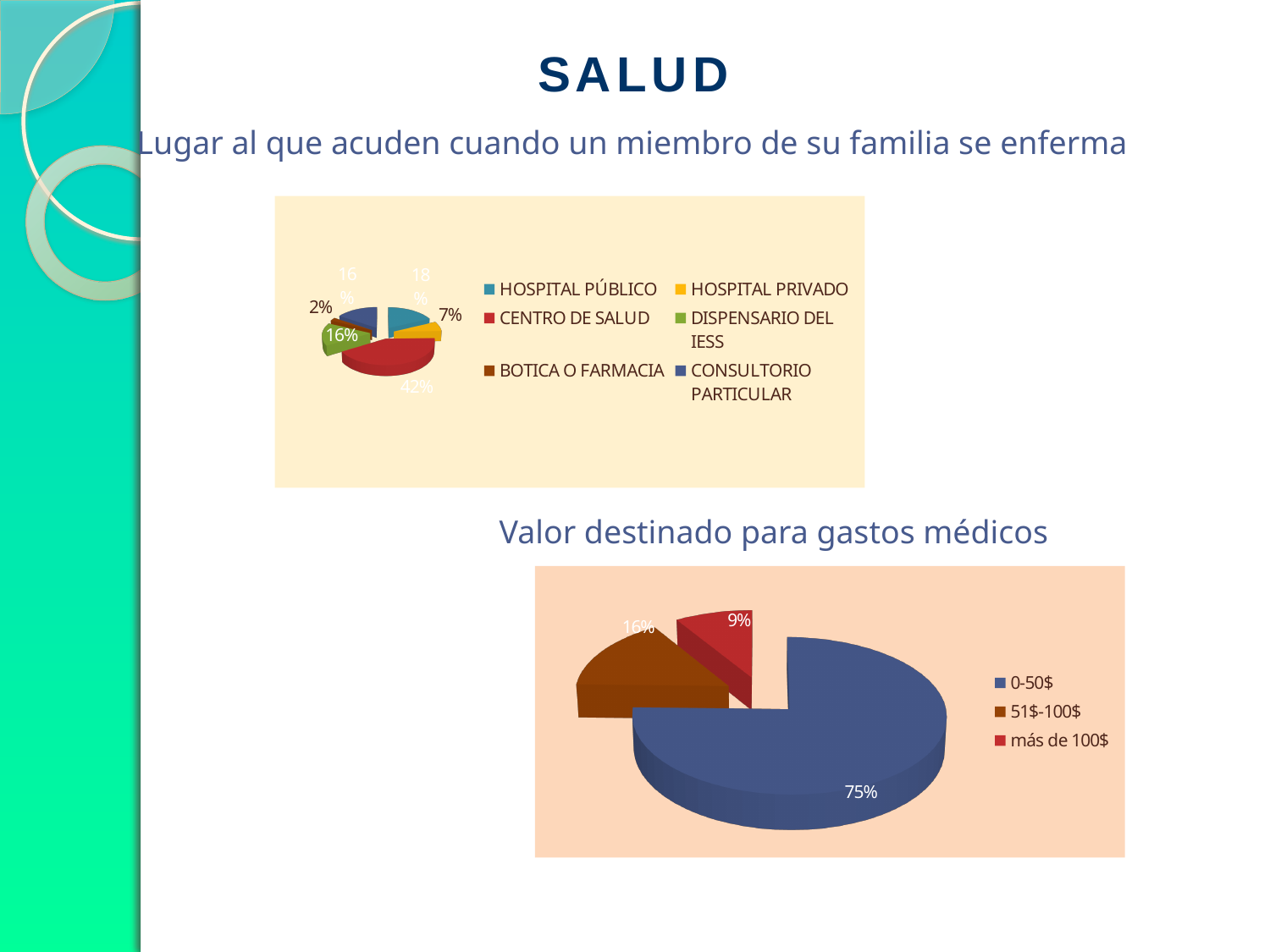
In the chart 'Lugar al que acuden cuando un miembro de su familia se enferma', which category has the largest share? CENTRO DE SALUD How many entries does the legend of the chart 'Lugar al que acuden cuando un miembro de su familia se enferma' list? 6 In the chart 'Valor destinado para gastos médicos', which category has the largest share? 0-50$ In the chart 'Valor destinado para gastos médicos', what percentage is shown for 'más de 100$'? 9% In the chart 'Valor destinado para gastos médicos', what is the difference in percentage points between 0-50$ and 51$-100$? 59 percentage points In the chart 'Valor destinado para gastos médicos', which category has the smallest share? más de 100$ In the chart 'Valor destinado para gastos médicos', what percentage is shown for 0-50$? 75% In the chart 'Valor destinado para gastos médicos', what percentage is shown for 51$-100$? 16% In the chart 'Lugar al que acuden cuando un miembro de su familia se enferma', what percentage is shown for CENTRO DE SALUD? 42% What kind of chart is 'Valor destinado para gastos médicos'? Pie chart How many categories does the chart 'Valor destinado para gastos médicos' show? 3 In the chart 'Valor destinado para gastos médicos', which is larger: 51$-100$ or 'más de 100$'? 51$-100$